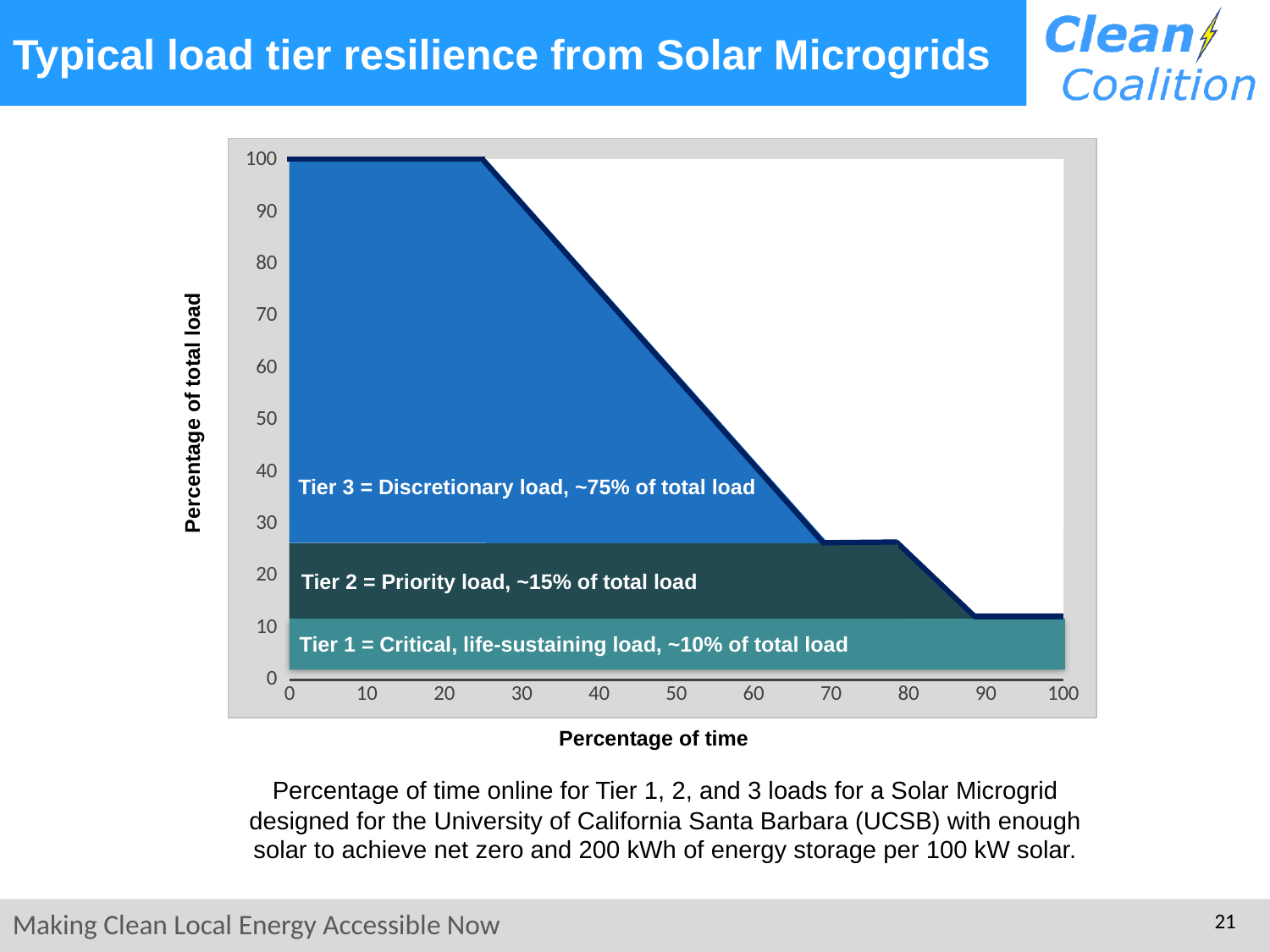
Is the percentage of total load at 40% of time greater or less than 60? greater What is the highest value shown on the y axis of the chart? 100 Does the percentage of total load rise or fall as the percentage of time increases along the x axis? Fall What is the percentage of total load at 10% of time? 100 What kind of chart is shown on the slide? Area chart What is the title of the y axis of the chart? Percentage of total load What is the title of the x axis of the chart? Percentage of time Is the percentage of total load at 60% of time greater or less than 30? greater Is the percentage of total load at 100% of time greater or less than 20? less How many load tiers are labelled on the chart? 3 Which is larger: the percentage of total load at 20% of time or at 80% of time? 20% of time